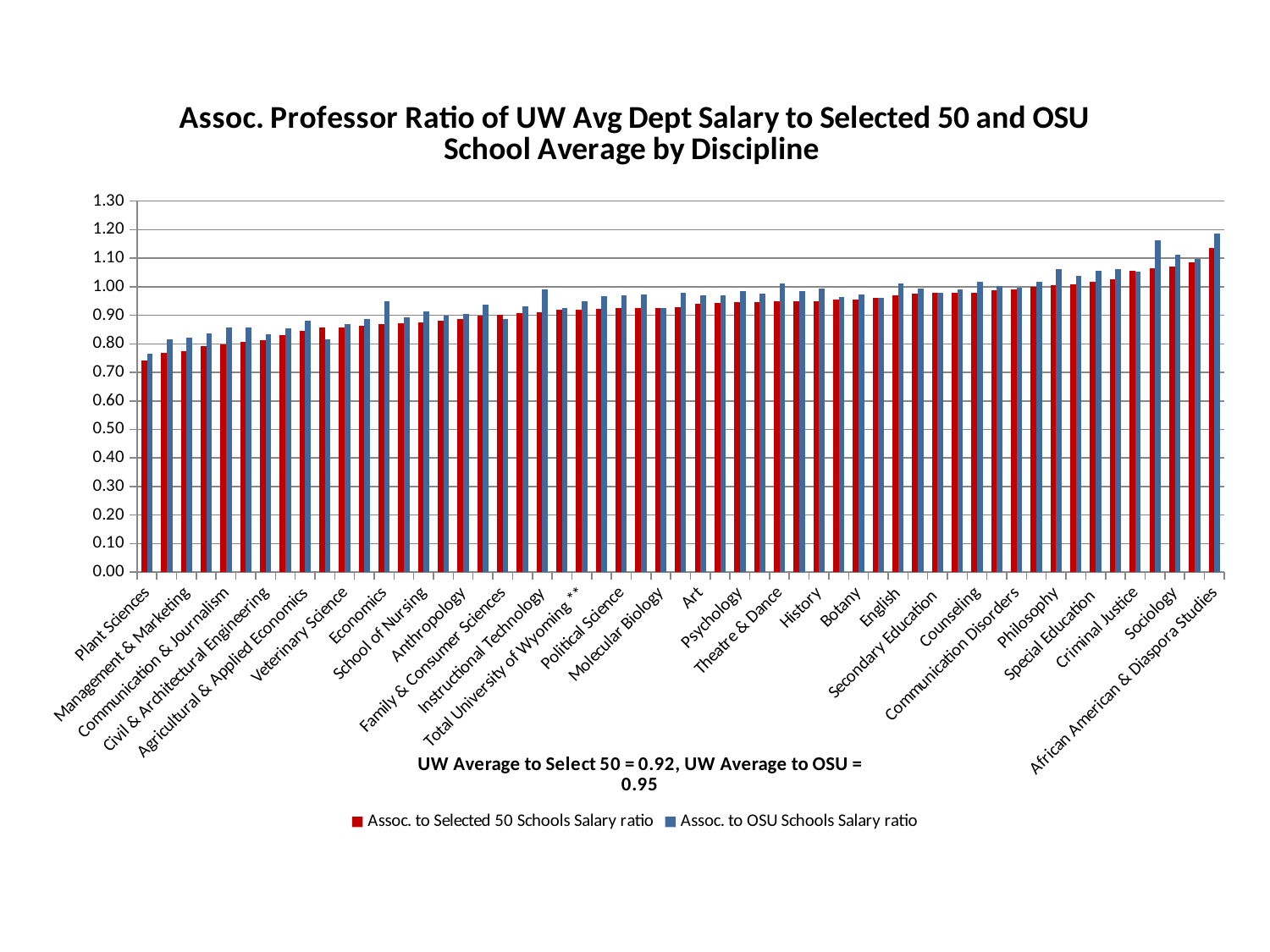
According to the x-axis title, what is the UW Average to OSU? 0.95 How many series does the legend list? 2 What kind of chart is shown on the slide? Bar chart Is the Assoc. to Selected 50 Schools Salary ratio for Plant Sciences greater or less than 0.80? less What are the two series named in the legend? Assoc. to Selected 50 Schools Salary ratio; Assoc. to OSU Schools Salary ratio Which discipline has the highest Assoc. to Selected 50 Schools Salary ratio? African American & Diaspora Studies For Theatre & Dance, which is larger: the Assoc. to Selected 50 Schools Salary ratio or the Assoc. to OSU Schools Salary ratio? Assoc. to OSU Schools Salary ratio What is the title of the chart? Assoc. Professor Ratio of UW Avg Dept Salary to Selected 50 and OSU School Average by Discipline According to the x-axis title, what is the UW Average to Select 50? 0.92 Do the Assoc. to Selected 50 Schools Salary ratio values generally rise or fall from left to right along the x axis? Rise Which discipline has the lowest Assoc. to Selected 50 Schools Salary ratio? Plant Sciences Is the Assoc. to OSU Schools Salary ratio for African American & Diaspora Studies greater or less than 1.10? greater